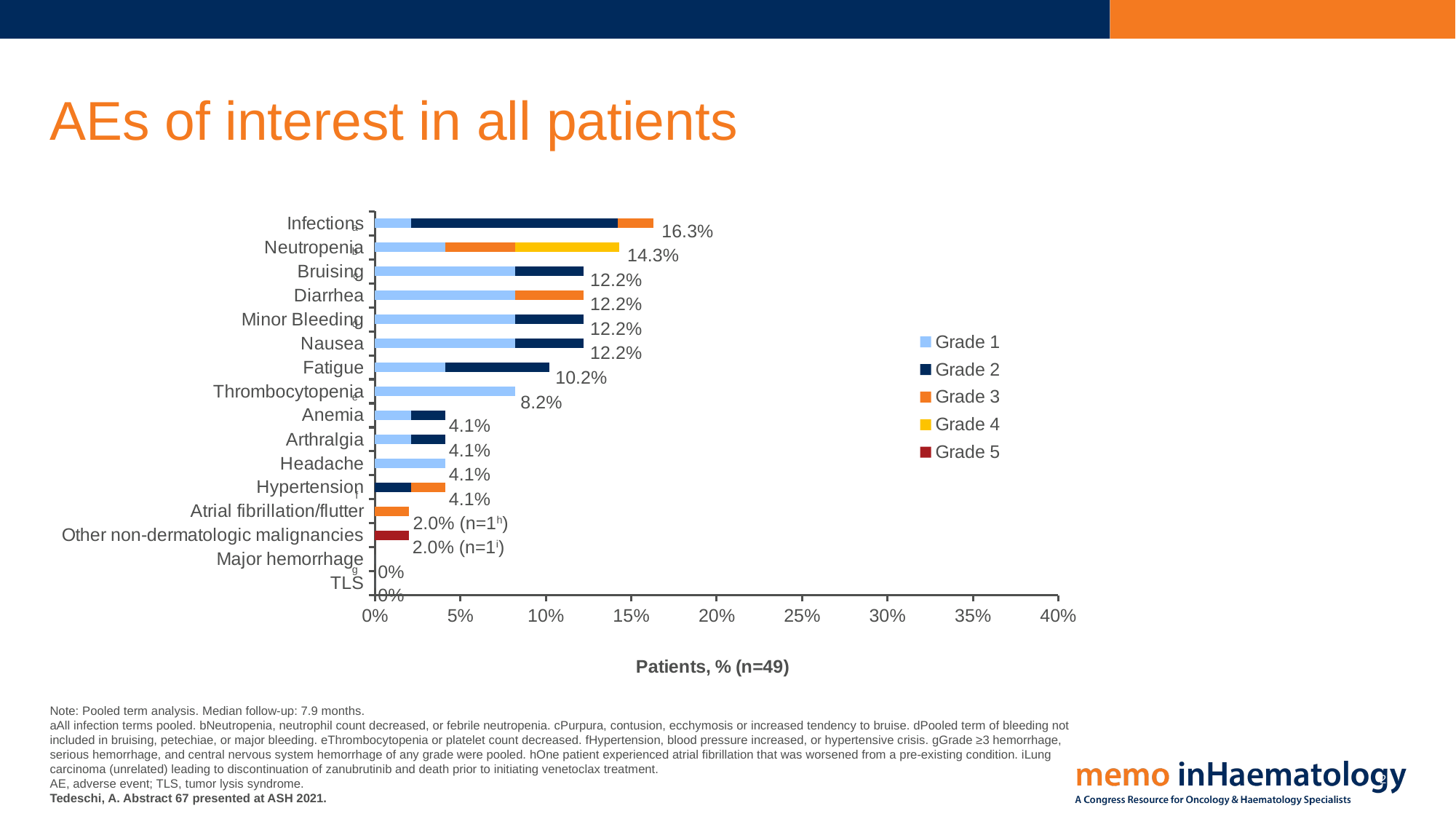
Is the total value for Bruising greater or less than 10%? greater What kind of chart is shown on the slide? Stacked bar chart What is the difference in percentage points between the totals for Infections and Neutropenia? 2.0 percentage points What is the total percentage of patients with Thrombocytopenia? 8.2% Which has a higher total percentage, Fatigue or Thrombocytopenia? Fatigue What is the total percentage of patients with Fatigue? 10.2% How many series does the legend list? 5 How many adverse event categories are listed on the y axis of the chart? 16 What is the total percentage of patients with Neutropenia? 14.3% What is the total percentage of patients with Infections? 16.3% Which adverse event has the highest total percentage of patients? Infections What is the title of the x axis of the chart? Patients, % (n=49)